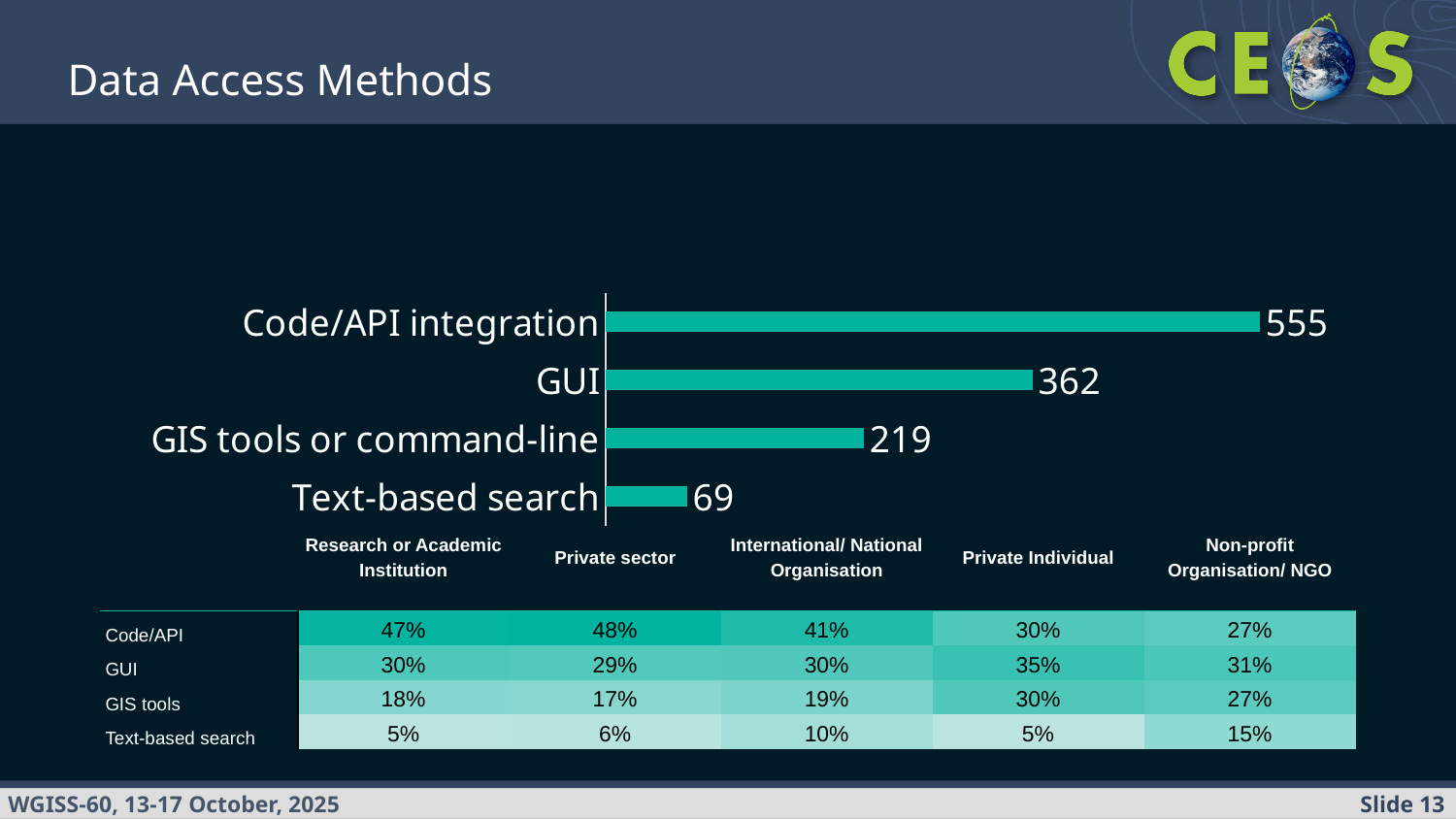
How many categories are shown in the bar chart? 4 What is the value for Text-based search in the bar chart? 69 Which data access method has the highest value in the bar chart? Code/API integration What is the value for GUI in the bar chart? 362 Which is larger in the bar chart, the value for GUI or the value for GIS tools or command-line? GUI What is the difference between the values for GIS tools or command-line and Text-based search in the bar chart? 150 Which data access method has the lowest value in the bar chart? Text-based search What is the value for GIS tools or command-line in the bar chart? 219 What kind of chart is shown on the slide? Bar chart What is the title of the slide containing the bar chart? Data Access Methods What is the difference between the values for Code/API integration and GUI in the bar chart? 193 What is the value for Code/API integration in the bar chart? 555